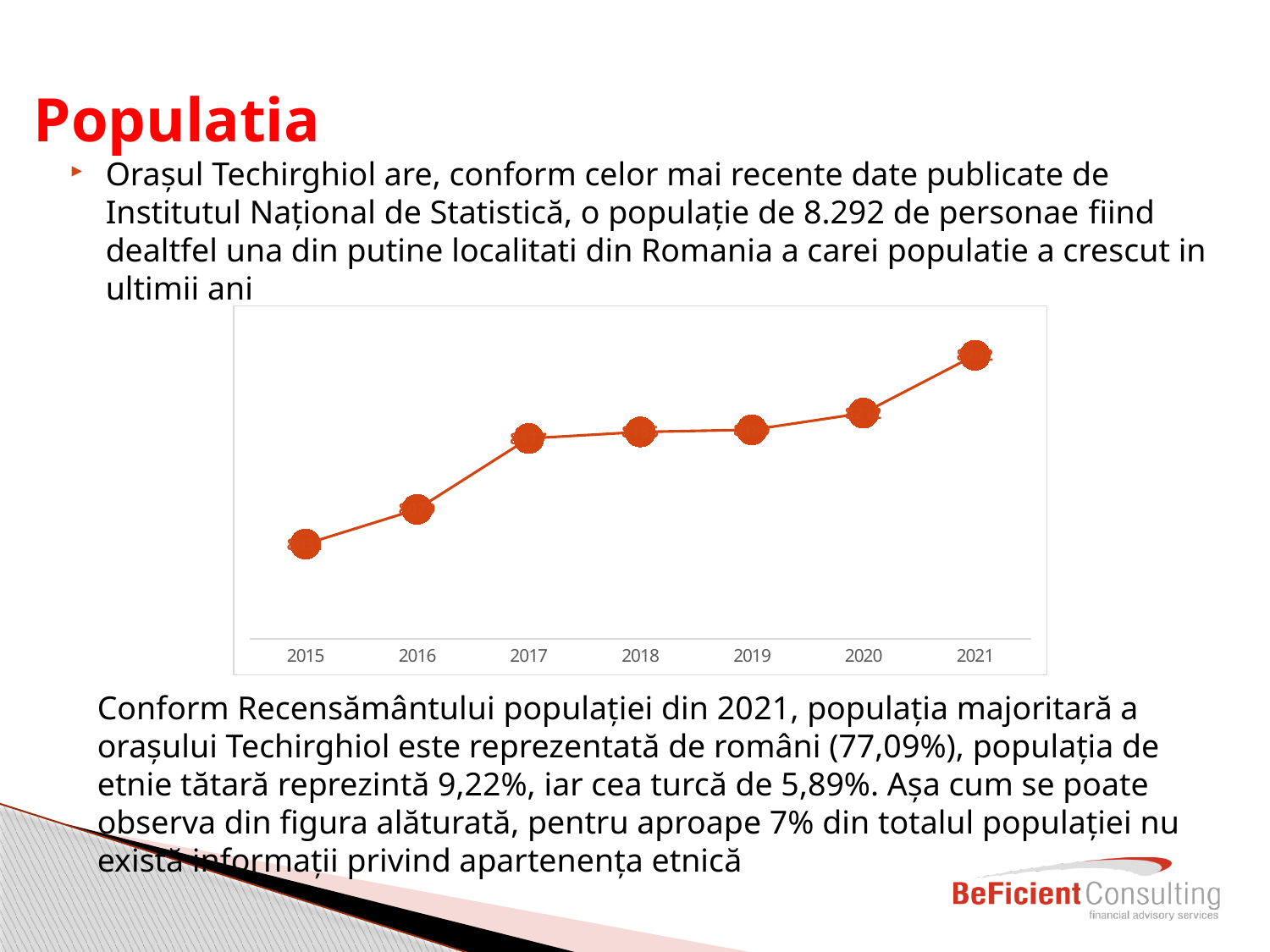
How many years are plotted on the x axis of the chart? 7 Which is larger in the chart, the value for 2016 or the value for 2017? 2017 Which is larger in the chart, the value for 2020 or the value for 2021? 2021 Which is larger in the chart, the value for 2015 or the value for 2016? 2016 What kind of chart is shown on the slide? line chart Which year has the lowest value in the chart? 2015 What is the first year shown on the x axis of the chart? 2015 Which year has the highest value in the chart? 2021 What colour is the line in the chart? orange-red Do the values in the chart generally rise or fall from 2015 to 2021? rise